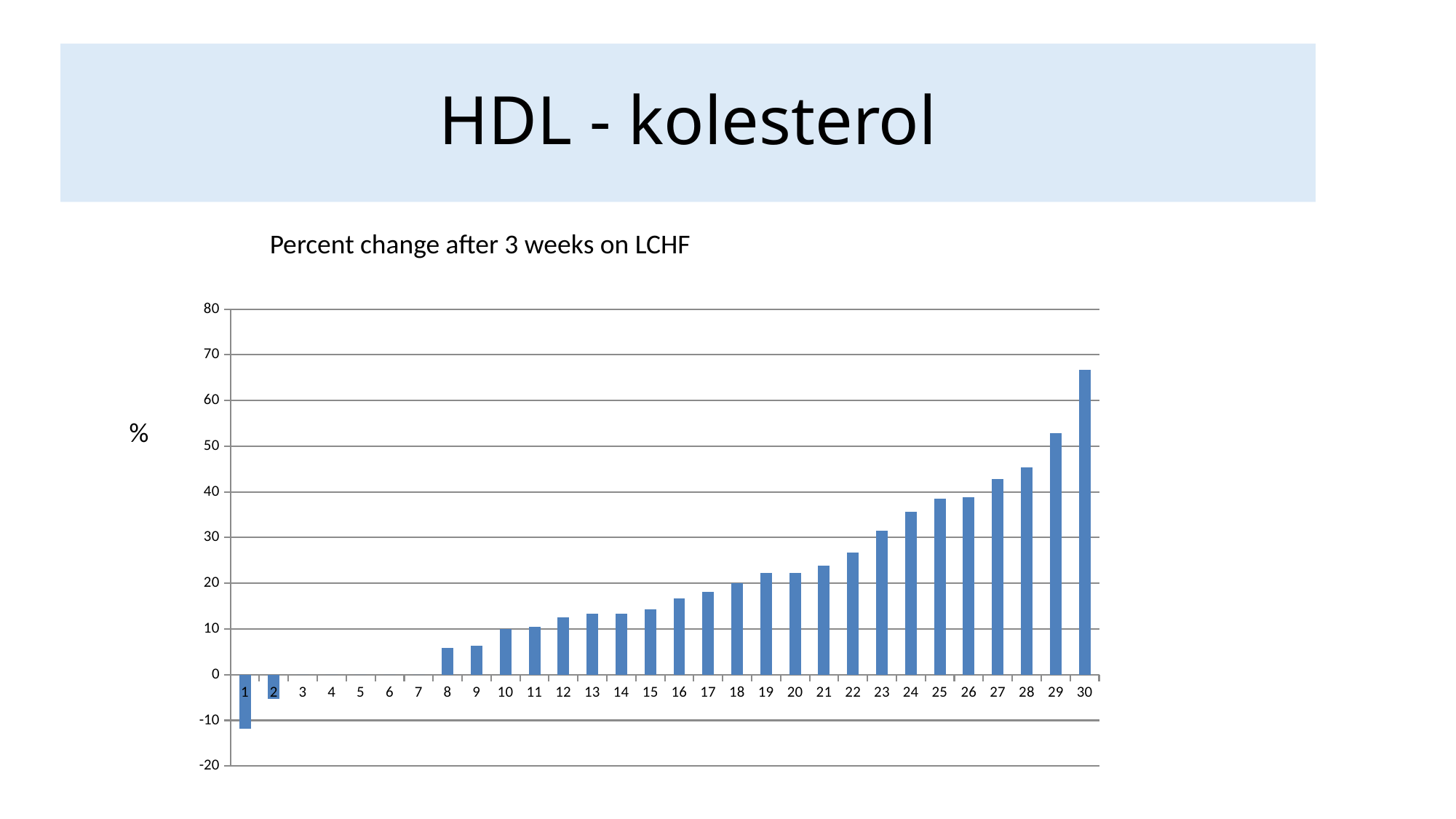
Is the value for category 2 greater or less than 0? less Which category has the lowest value in the chart? 1 What kind of chart is shown on the slide? bar chart What is the title text shown above the chart? Percent change after 3 weeks on LCHF Which has the larger value, category 29 or category 30? 30 How many categories are shown on the x axis of the chart? 30 Is the value for category 30 greater or less than 60? greater Which category has the highest value in the chart? 30 Is the value for category 24 greater or less than 30? greater Do the values generally rise or fall from category 1 to category 30? rise